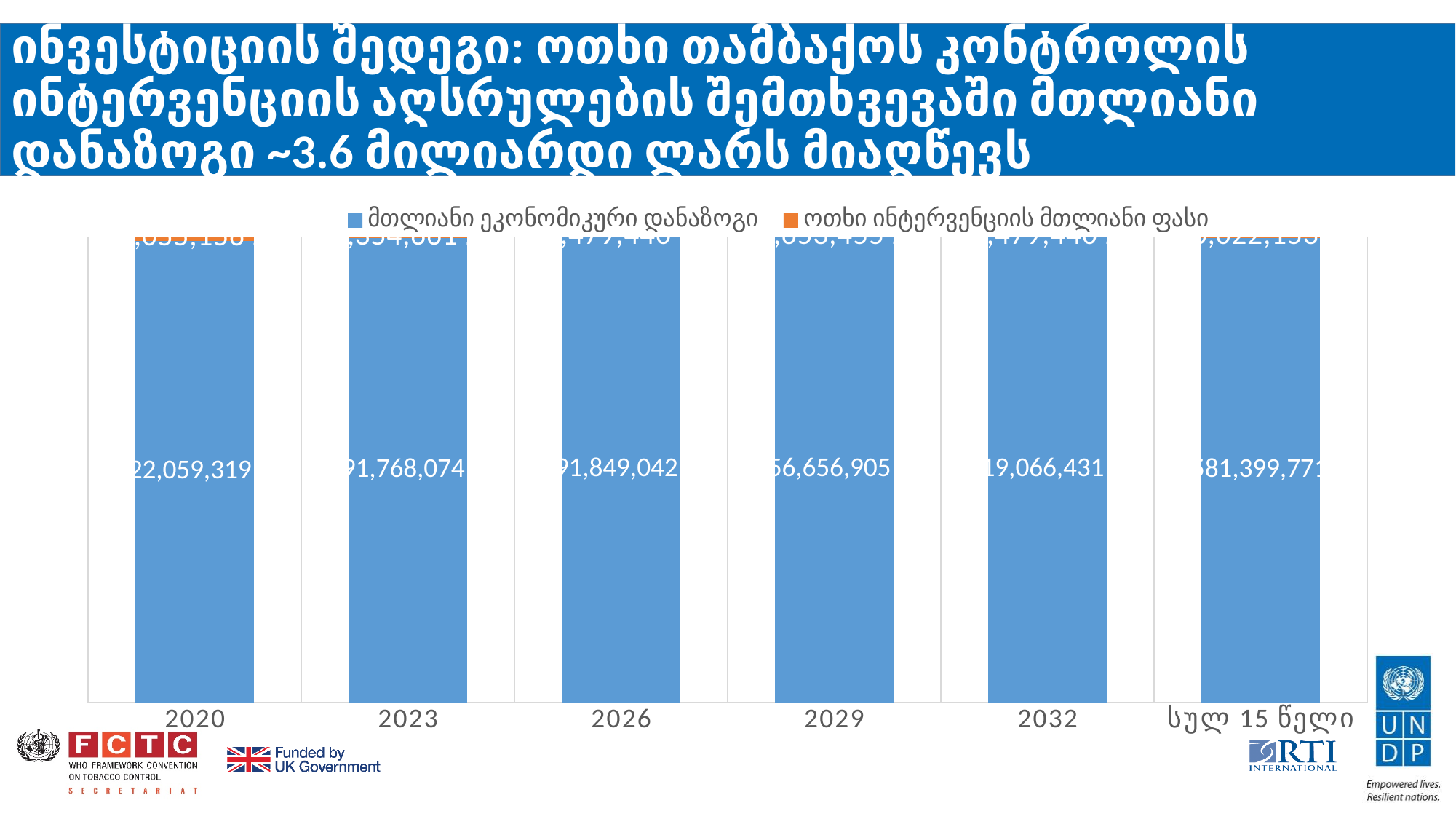
What is the label of the first category on the x axis? 2020 How many categories are shown along the x axis of the chart? 6 Which series is shown in blue in the legend? მთლიანი ეკონომიკური დანაზოგი How many of the x-axis categories are years? 5 Which series is shown in orange in the legend? ოთხი ინტერვენციის მთლიანი ფასი What is the label of the last category on the x axis? სულ 15 წელი What kind of chart is shown on the slide? bar chart How many series does the chart's legend list? 2